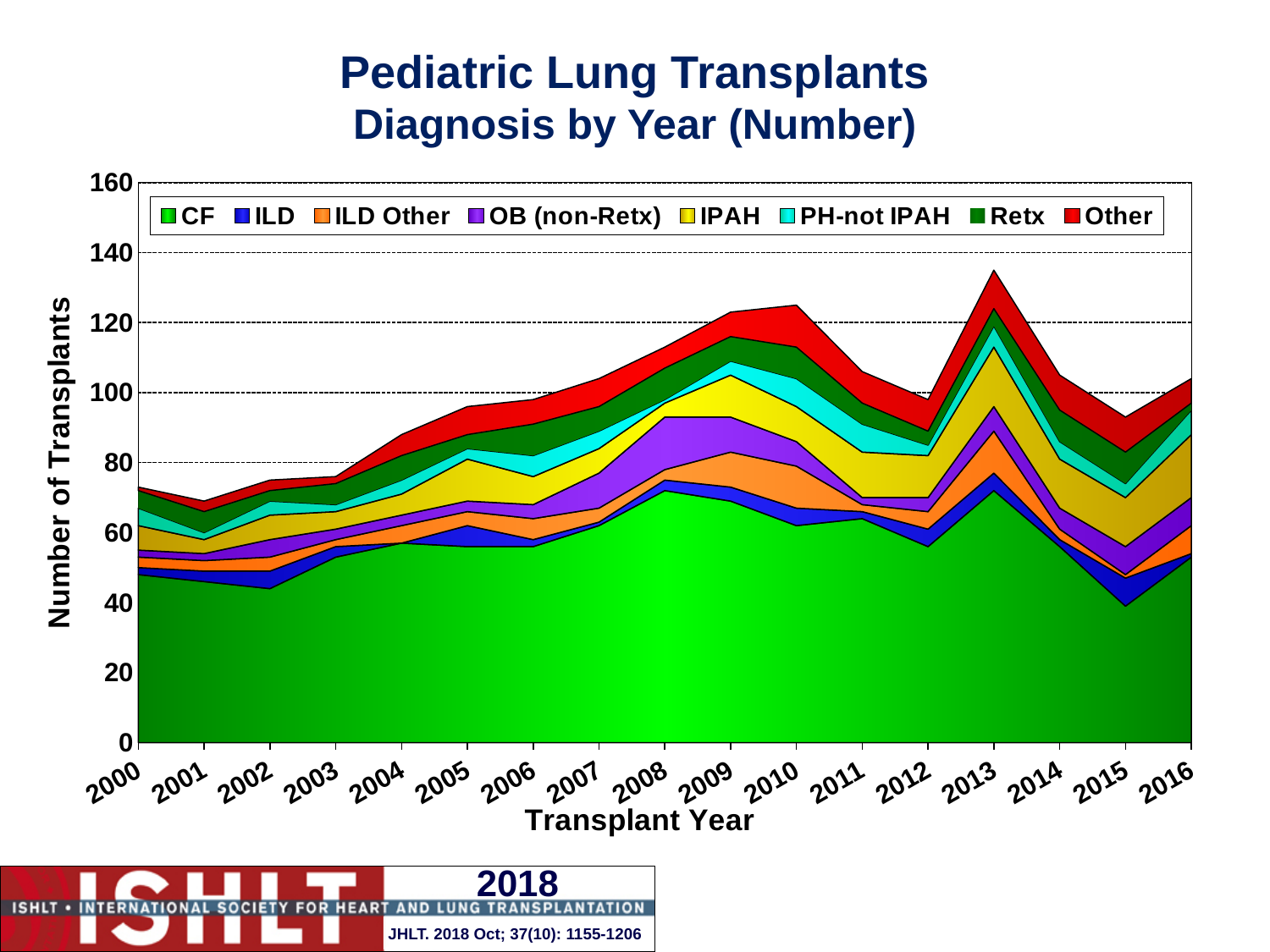
Does the total number of transplants rise or fall from 2013 to 2015? fall How many series does the legend list? 8 How many transplant years are plotted along the x axis? 17 In which transplant year is the total number of pediatric lung transplants lowest? 2001 Is the number of CF transplants in 2015 greater or less than 60? less In which transplant year is the total number of pediatric lung transplants highest? 2013 Which year has a larger total number of transplants, 2012 or 2013? 2013 Is the total number of transplants in 2001 greater or less than 80? less Is the total number of transplants in 2008 greater or less than 100? greater What kind of chart is shown on the slide? Stacked area chart What is the label of the y axis? Number of Transplants